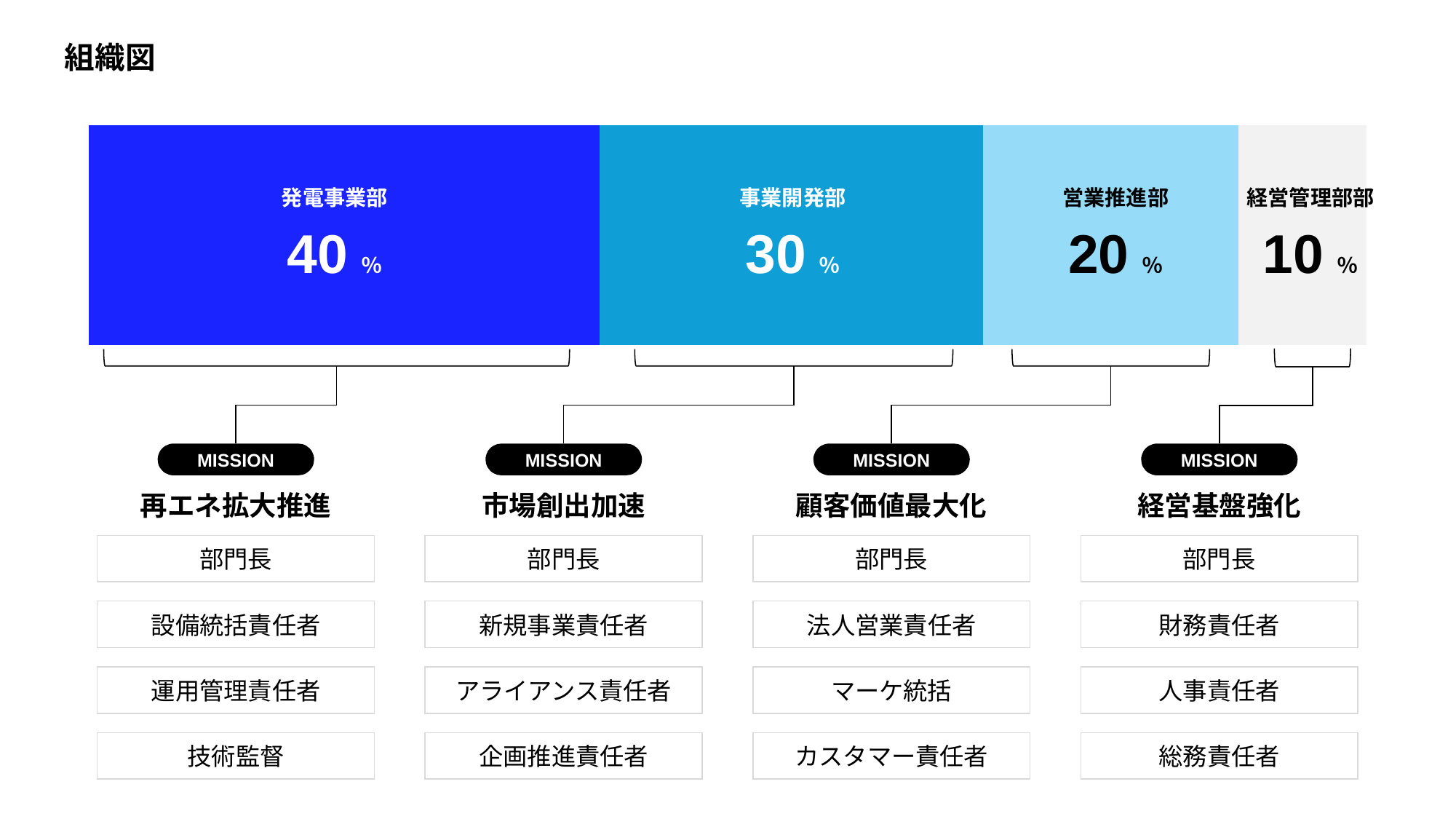
What percentage is shown for 経営管理部部? 10% Which has a larger share, 事業開発部 or 営業推進部? 事業開発部 What percentage is shown for 事業開発部? 30% What percentage is shown for 営業推進部? 20% What is the mission listed under 営業推進部? 顧客価値最大化 What is the difference in percentage between 発電事業部 and 事業開発部? 10% What is the total of the four percentages shown in the bar? 100% Which department has the largest share in the bar? 発電事業部 What is the difference in percentage between 営業推進部 and 経営管理部部? 10% What percentage is shown for 発電事業部? 40% Which department has the smallest share in the bar? 経営管理部部 How many departments are shown in the bar? 4